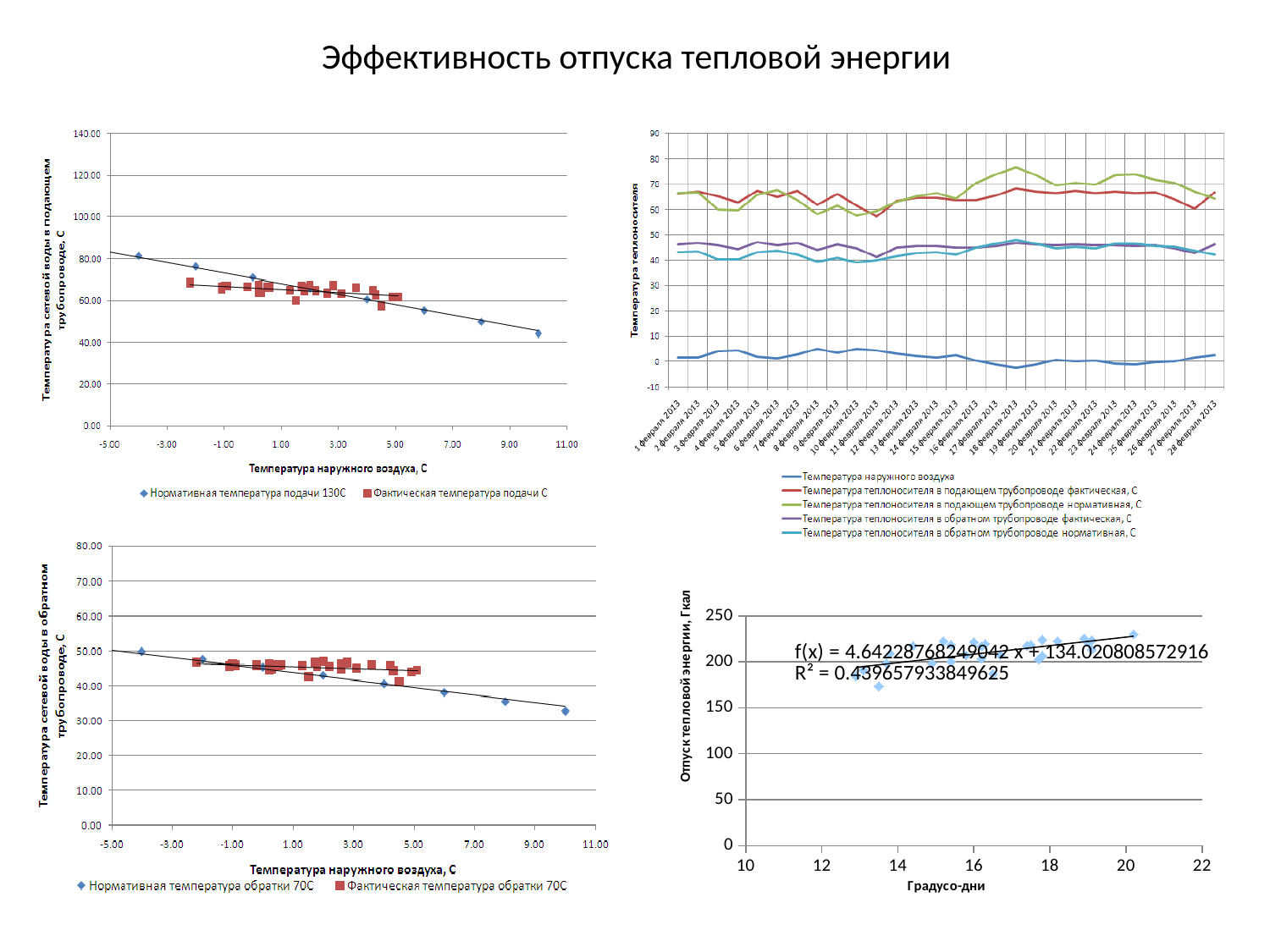
In the top-right chart, is the outdoor air temperature (Температура наружного воздуха) on 1 февраля 2013 greater or less than 10? less How many series does the legend of the top-left chart (supply pipe temperature vs outdoor temperature) list? 2 What kind of chart is the top-right chart showing temperatures over February 2013? line chart How many dates are plotted along the x axis of the top-right chart? 28 In the top-right chart, is the normative supply pipe temperature (Температура теплоносителя в подающем трубопроводе нормативная) on 18 февраля 2013 greater or less than 70? greater What is the x-axis title of the bottom-right chart? Градусо-дни What kind of chart is the bottom-right chart with the axis 'Градусо-дни'? scatter chart In the top-left chart, do the normative supply temperature values rise or fall as the outdoor air temperature increases? fall In the top-right chart, on 18 февраля 2013, which is higher: the normative supply pipe temperature or the actual supply pipe temperature? normative supply pipe temperature In the bottom-left chart, is the normative return temperature at an outdoor temperature of -4.00 greater or less than 40.00? greater How many series does the legend of the top-right line chart list? 5 What R² value is shown on the bottom-right chart? R² = 0.439657933849625